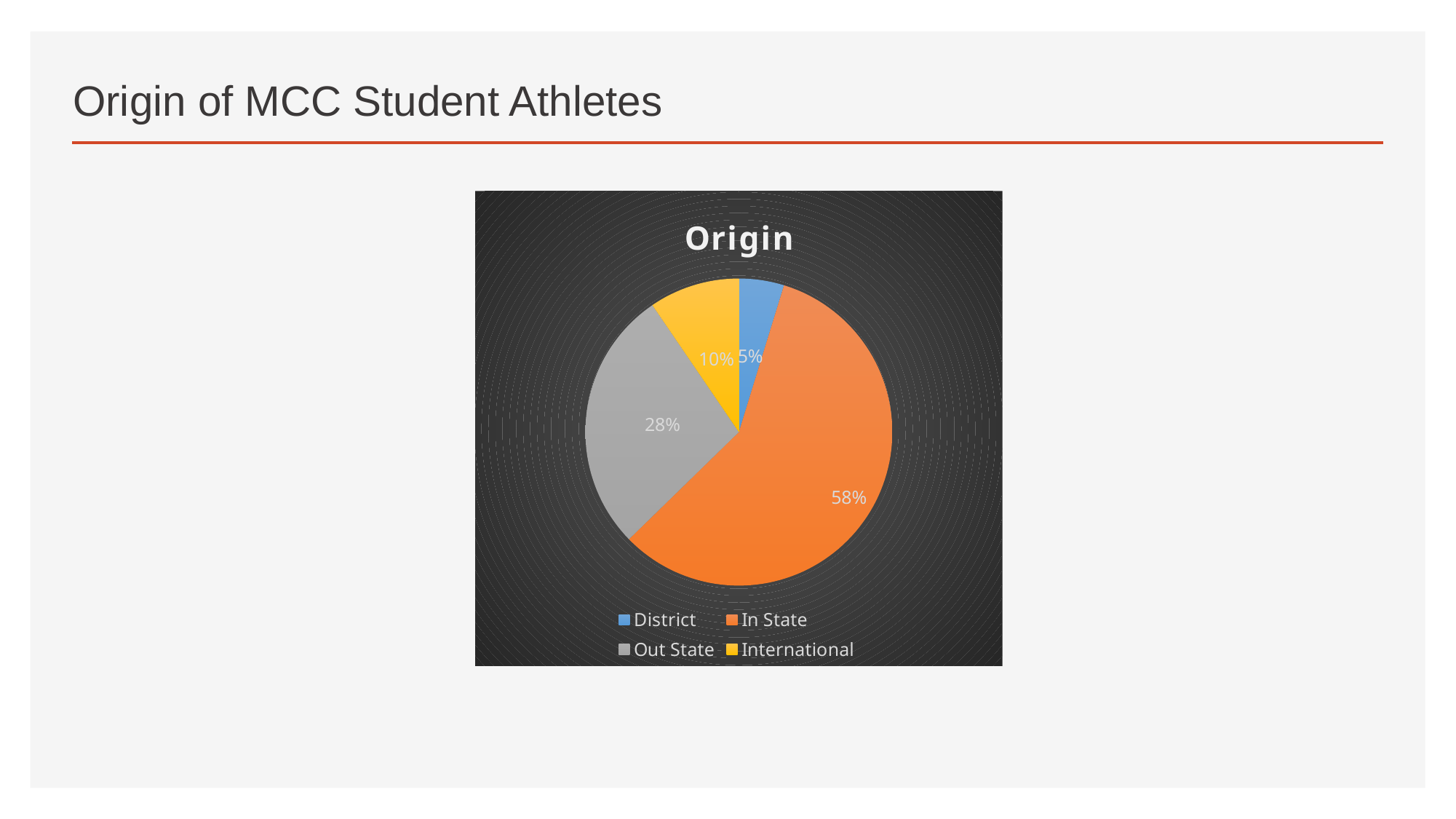
What is the difference in percentage points between In State and Out State? 30 What share of the pie does District represent? 5% How many categories are shown in the pie chart? 4 Which is larger, the Out State slice or the International slice? Out State What share of the pie does International represent? 10% What kind of chart is shown on the slide? Pie chart Which category has the largest slice of the pie? In State What share of the pie does Out State represent? 28% Which colour represents International in the legend? Yellow Which category has the smallest slice of the pie? District What share of the pie does In State represent? 58% What is the title of the chart? Origin